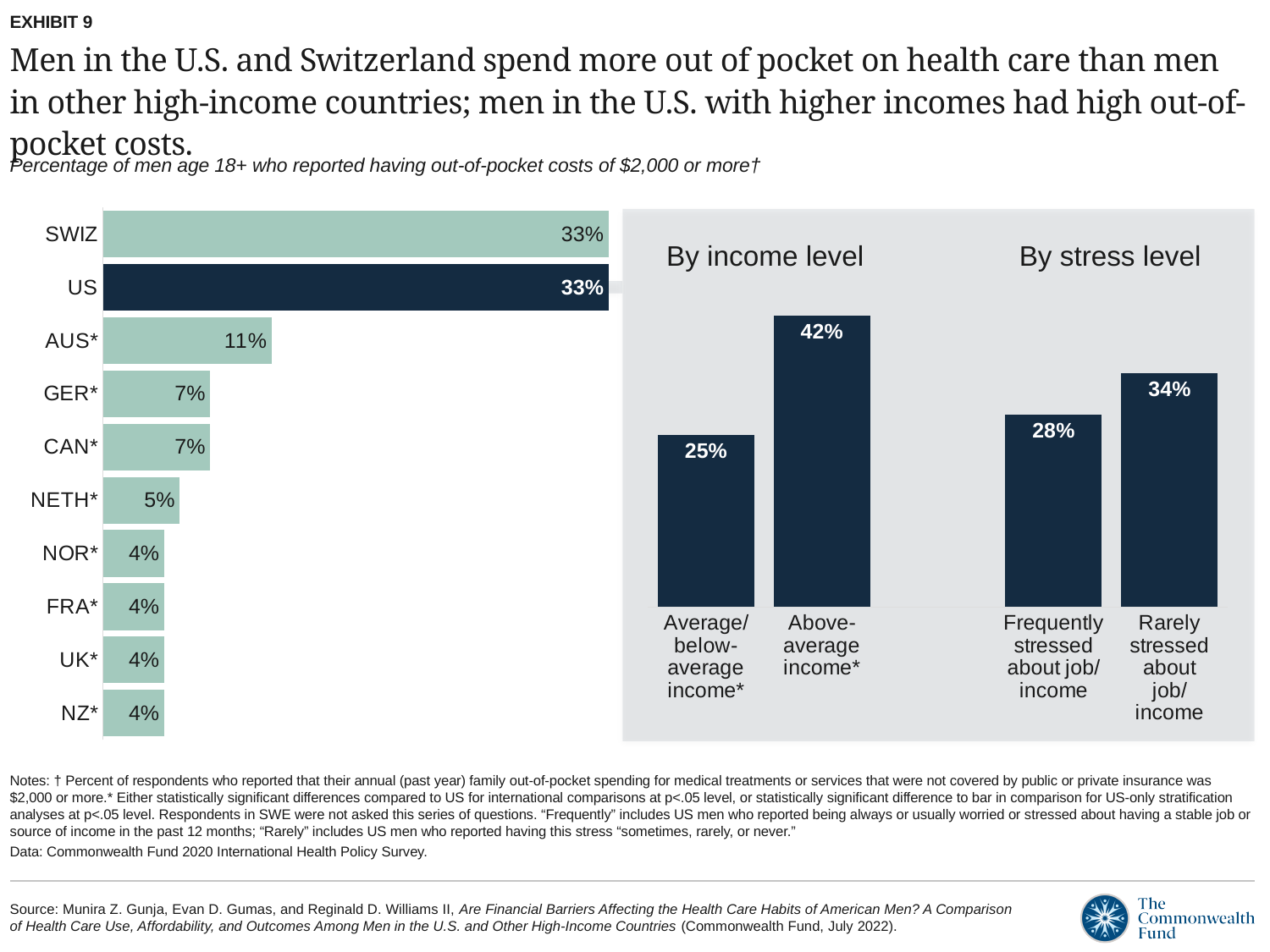
In the country bar chart on the left, what percentage is shown for NETH*? 5% In the country bar chart on the left, how many countries are listed? 10 In the 'By stress level' chart, which category has the higher value? Rarely stressed about job/income In the 'By income level' chart, what is the difference between the above-average income and average/below-average income values? 17 percentage points In the 'By stress level' chart, what is the difference between the two bars? 6 percentage points In the 'By income level' chart, what percentage is shown for above-average income? 42% What kind of chart is the country chart on the left? Bar chart In the 'By stress level' chart, what percentage is shown for men frequently stressed about job/income? 28% In the country bar chart on the left, what percentage is shown for the US? 33% In the country bar chart on the left, which is larger, the value for AUS* or the value for CAN*? AUS* In the country bar chart on the left, what percentage is shown for AUS*? 11% In the country bar chart on the left, what is the difference between the values for AUS* and GER*? 4 percentage points